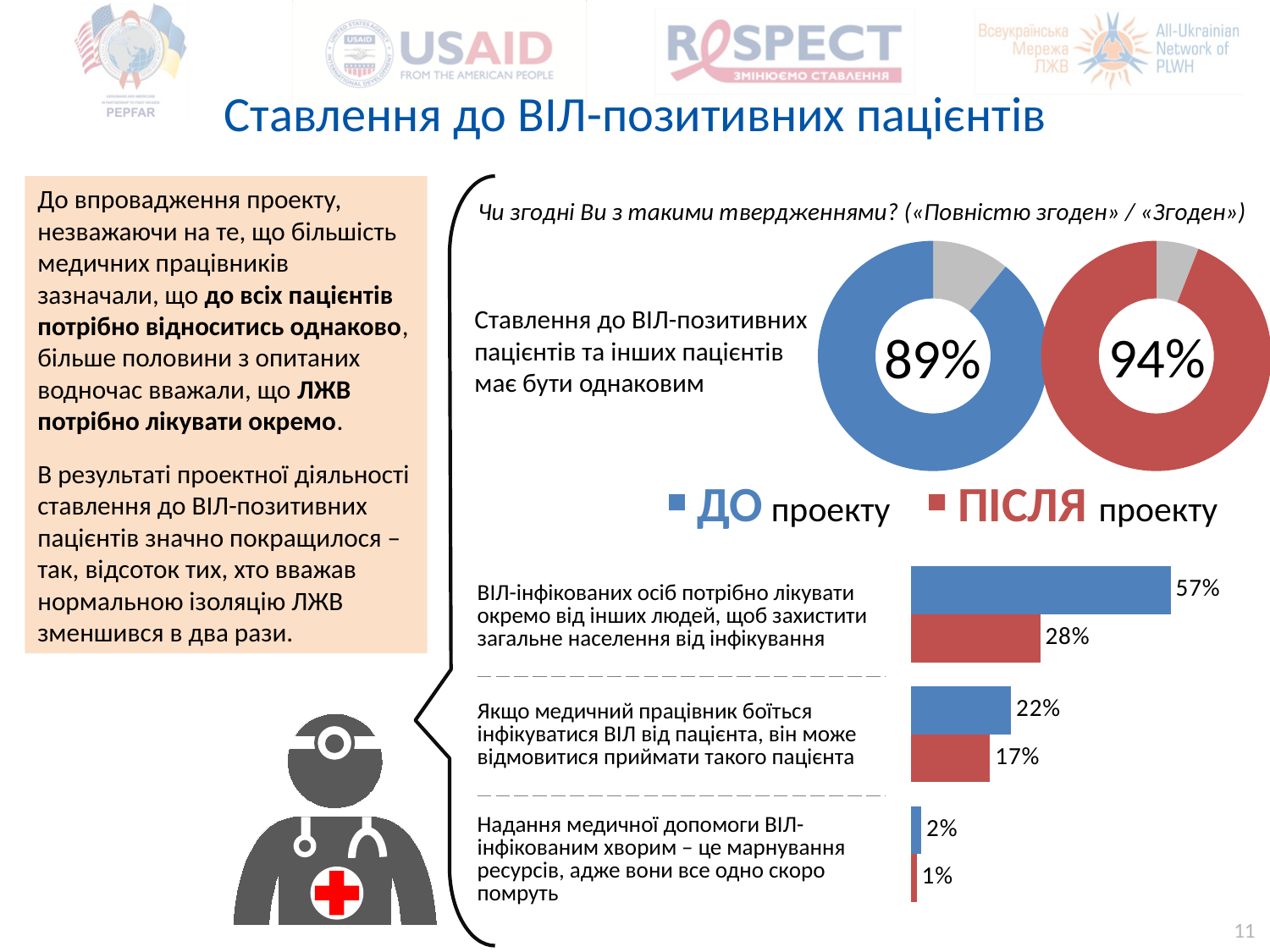
In the donut charts at the top right, by how many percentage points did agreement that attitudes should be the same increase from before to after the project? 5 percentage points In the donut charts at the top right, what share agreed that attitudes toward HIV-positive and other patients should be the same before the project (ДО проекту)? 89% In the bar chart at the bottom right, which statement has the lowest value after the project? Надання медичної допомоги ВІЛ-інфікованим хворим – це марнування ресурсів (providing care to HIV-infected patients is a waste of resources) How many series does the legend list (ДО проекту / ПІСЛЯ проекту)? 2 In the bar chart at the bottom right, what was the value after the project for the statement that a medical worker afraid of HIV infection may refuse to accept such a patient? 17% In the donut charts at the top right, what share agreed that attitudes toward HIV-positive and other patients should be the same after the project (ПІСЛЯ проекту)? 94% In the bar chart at the bottom right, what was the value before the project for the statement that providing medical care to HIV-infected patients is a waste of resources? 2% In the bar chart at the bottom right, which statement has the highest value before the project? ВІЛ-інфікованих осіб потрібно лікувати окремо від інших людей (HIV-infected people should be treated separately) In the bar chart at the bottom right, what was the value after the project (ПІСЛЯ проекту) for the statement that HIV-infected people should be treated separately from others? 28% In the bar chart at the bottom right, what was the value before the project (ДО проекту) for the statement that HIV-infected people should be treated separately from others? 57% In the bar chart at the bottom right, is the before-project value for the statement about a medical worker refusing a patient larger or smaller than the after-project value? larger In the bar chart at the bottom right, what is the difference between the before and after values for the statement that HIV-infected people should be treated separately? 29 percentage points